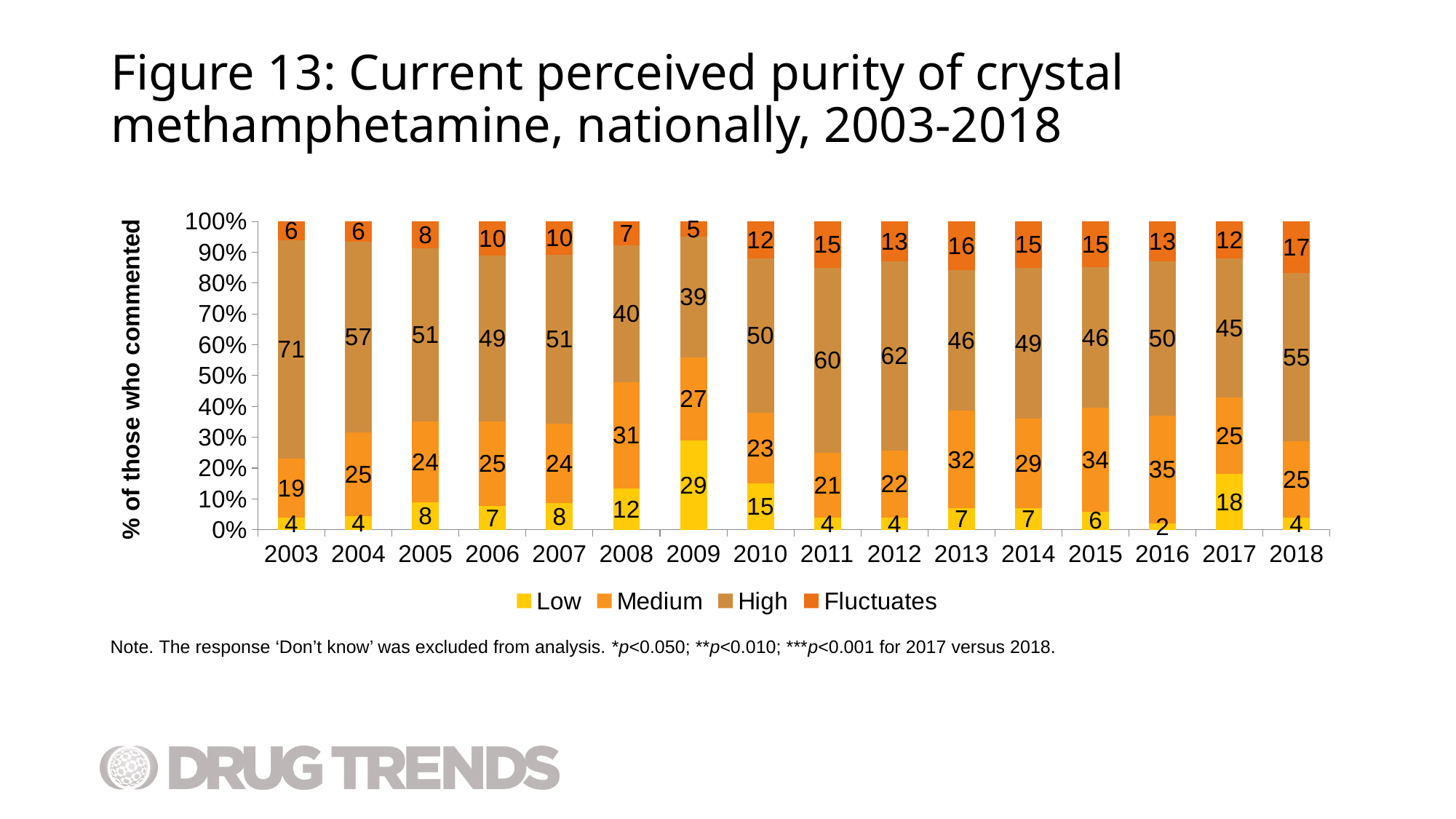
What is the value for Medium in 2016? 35 How many years are shown on the x axis? 16 What is the value for Fluctuates in 2018? 17 What kind of chart is shown? Stacked bar chart What is the value for High in 2003? 71 In which year is the Low value lowest? 2016 What is the value for Low in 2009? 29 In which year is the Low value highest? 2009 What is the difference between the High value in 2003 and the High value in 2018? 16 What is the y-axis label of the chart? % of those who commented How many series does the legend list? 4 Which is larger, the Medium value in 2015 or the Medium value in 2017? 2015